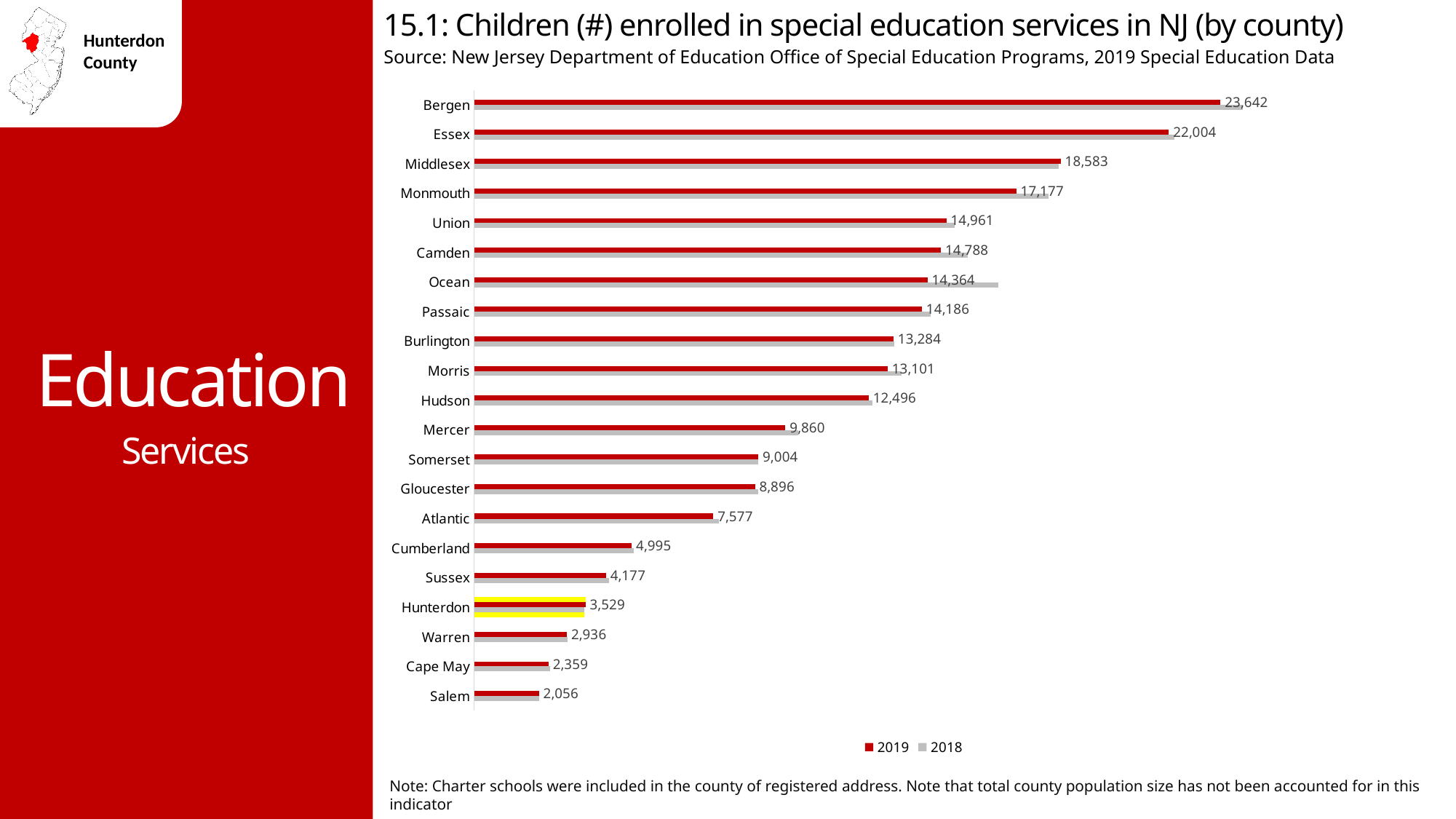
How many series does the legend list? 2 What is the 2019 value for Bergen? 23,642 How many counties are shown on the chart? 21 What is the difference between the 2019 values for Hunterdon and Warren? 593 Which has a larger 2019 value, Mercer or Somerset? Mercer What is the 2019 value for Hunterdon? 3,529 Which county has the lowest 2019 value? Salem What is the 2019 value for Cape May? 2,359 What is the difference between the 2019 values for Bergen and Essex? 1,638 For Ocean, which is larger: the 2019 bar or the 2018 bar? 2018 What kind of chart is shown? Bar chart Which county has the highest 2019 value? Bergen